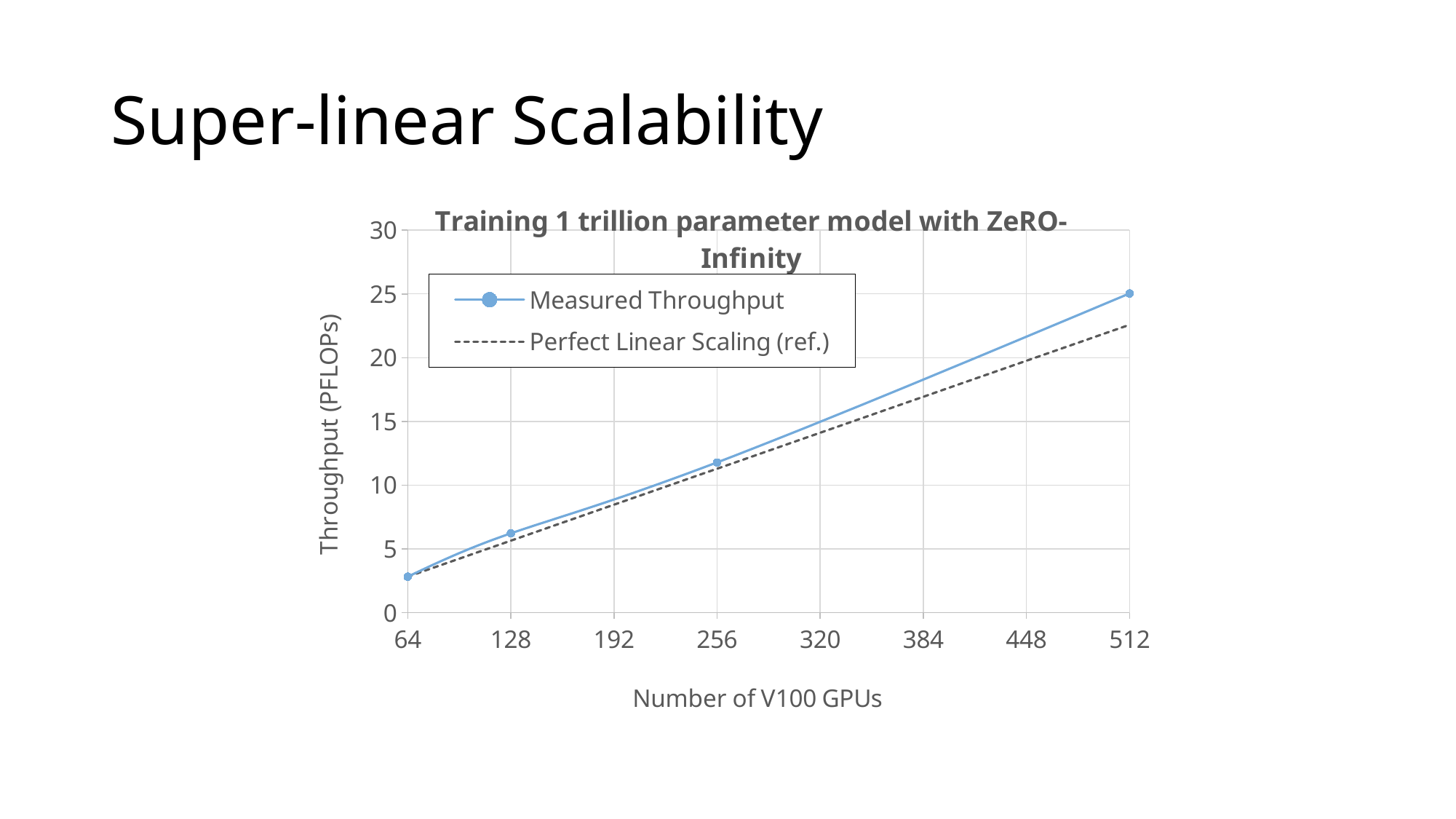
What kind of chart is shown on the slide? line chart What is the title of the chart? Training 1 trillion parameter model with ZeRO-Infinity Is the Measured Throughput at 512 GPUs greater or less than 20 PFLOPs? greater Is the Measured Throughput at 256 GPUs greater or less than 15 PFLOPs? less Does the Measured Throughput rise or fall as the number of V100 GPUs increases? rises How many data points are marked on the Measured Throughput line? 4 Which is larger, the Measured Throughput at 512 GPUs or at 256 GPUs? 512 GPUs At which number of GPUs is the Measured Throughput lowest? 64 What is the label of the y axis? Throughput (PFLOPs) At which number of GPUs is the Measured Throughput highest? 512 How many series does the legend list? 2 Is the Measured Throughput at 64 GPUs greater or less than 5 PFLOPs? less